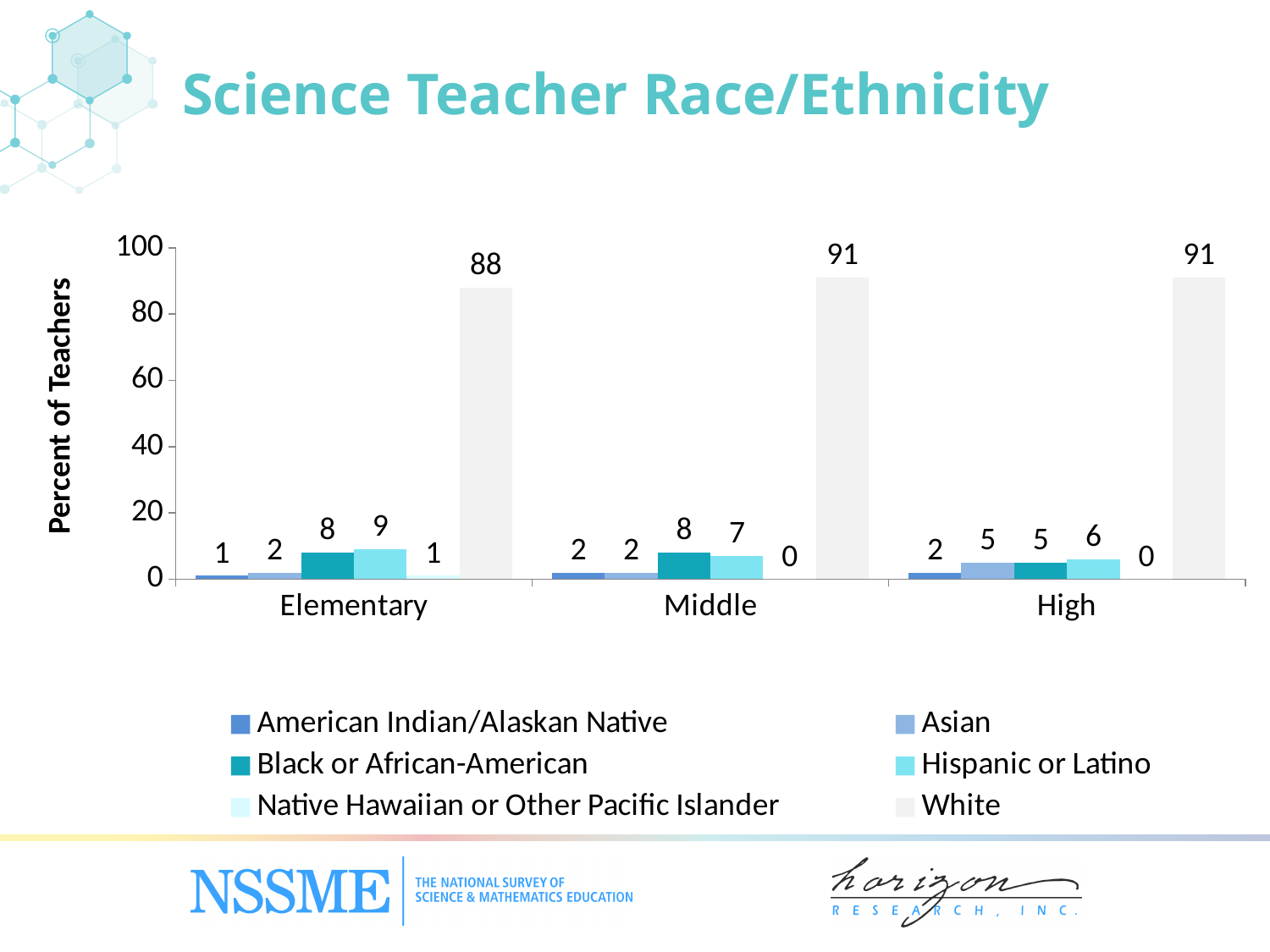
What percent of elementary science teachers are Native Hawaiian or Other Pacific Islander? 1 What is the label of the y axis? Percent of Teachers Is the percent of Hispanic or Latino science teachers higher at the elementary level or the high school level? Elementary Which race/ethnicity has the highest percentage among middle school science teachers? White What is the difference between the percent of White science teachers at the high school level and at the elementary level? 3 What percent of elementary science teachers are White? 88 What percent of high school science teachers are Asian? 5 How many school levels are shown on the x axis? 3 What type of chart is shown on the slide? Bar chart How many race/ethnicity series does the legend list? 6 Which race/ethnicity has the lowest percentage among high school science teachers? Native Hawaiian or Other Pacific Islander What percent of middle school science teachers are Hispanic or Latino? 7